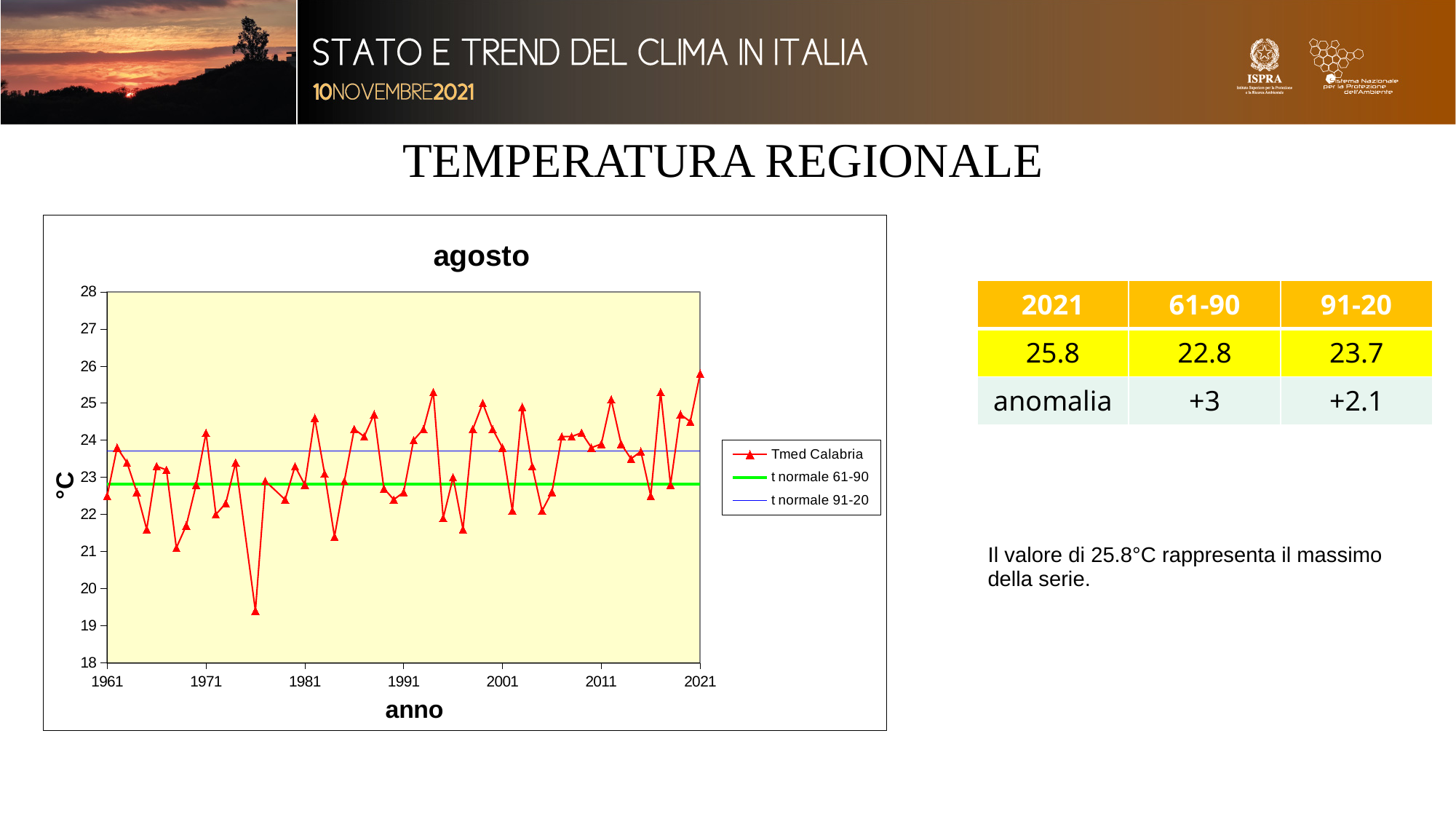
Which is higher, the t normale 91-20 line or the t normale 61-90 line? t normale 91-20 What is the difference between the 2021 value and the t normale 61-90 value? +3 What is the title of the chart? agosto What kind of chart is shown on the slide? line chart How many series does the chart legend list? 3 What is the value of the t normale 61-90 line? 22.8 What is the Tmed Calabria value for 2021? 25.8 Which year has the highest Tmed Calabria value in the series? 2021 What is the label on the y axis of the chart? °C What is the difference between the 2021 value and the t normale 91-20 value? +2.1 What is the value of the t normale 91-20 line? 23.7